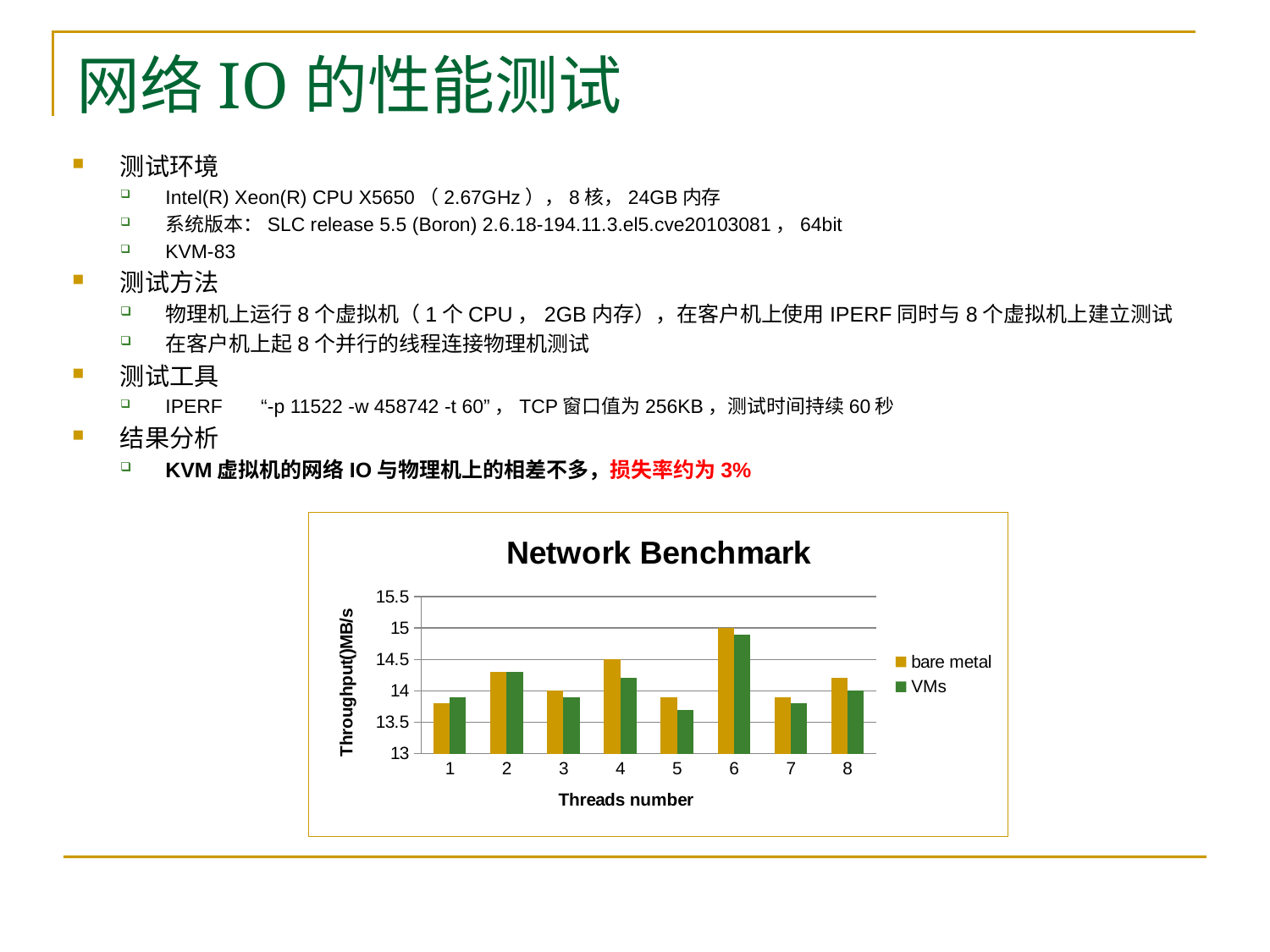
For thread number 4, which series has the larger throughput, bare metal or VMs? bare metal For which thread number is the VMs throughput highest? 6 For which thread number is the bare metal throughput highest? 6 What type of chart is shown on the slide? bar chart For thread number 6, which series has the larger throughput, bare metal or VMs? bare metal Is the bare metal value for thread number 1 greater or less than 14? less Is the VMs value for thread number 5 greater or less than 14? less How many thread-number categories are shown on the x axis? 8 What is the label of the x axis? Threads number How many series does the chart legend list? 2 What is the title of the chart? Network Benchmark Is the bare metal value for thread number 6 greater or less than 14.5? greater